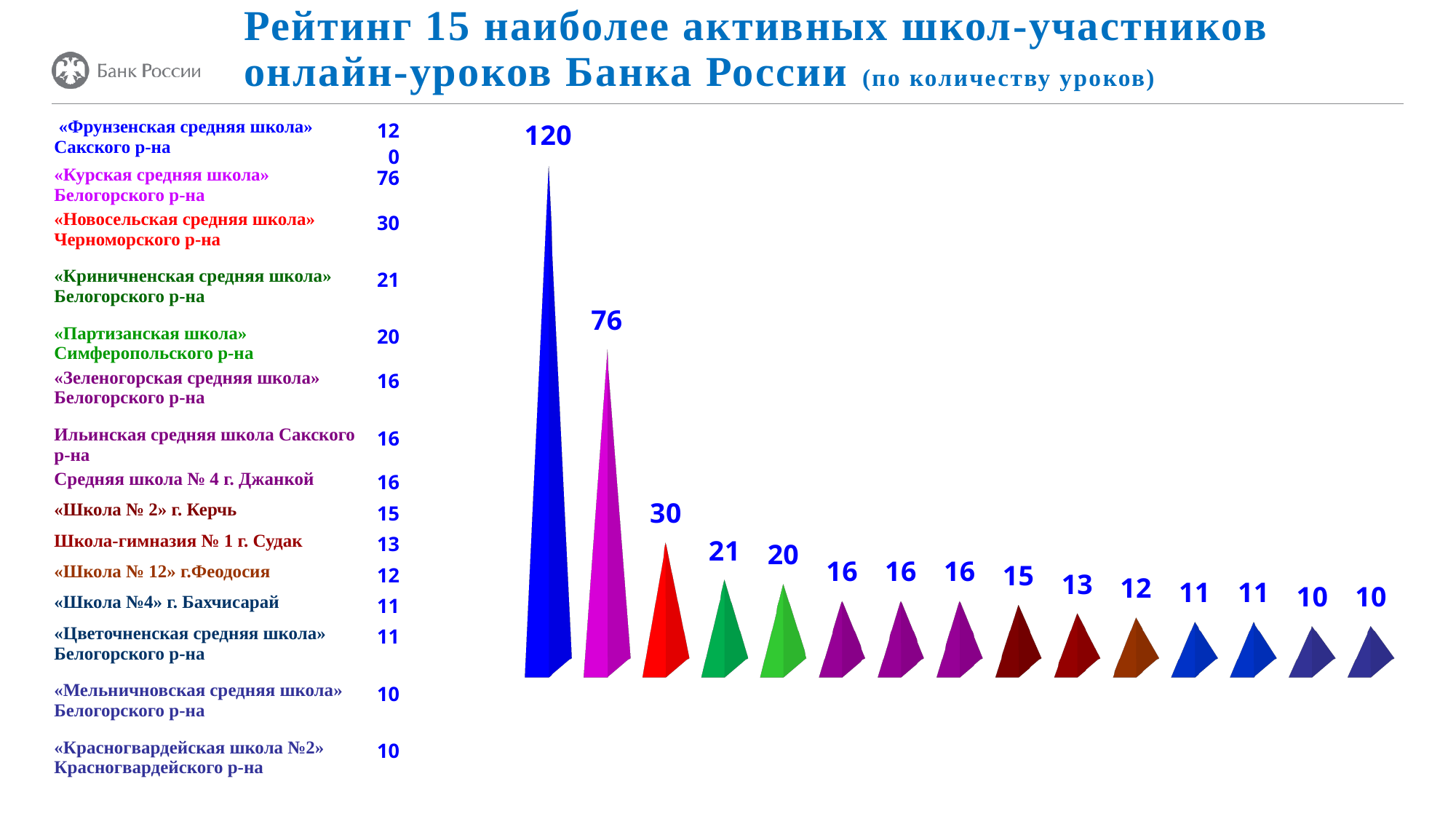
What kind of chart is shown on the slide? bar chart Which school has the highest number of lessons? «Фрунзенская средняя школа» Сакского р-на What is the lowest value shown in the chart? 10 How many schools (bars) are plotted in the chart? 15 How many lessons does «Курская средняя школа» Белогорского р-на have? 76 Which has more lessons: «Новосельская средняя школа» Черноморского р-на or «Криничненская средняя школа» Белогорского р-на? «Новосельская средняя школа» Черноморского р-на What is the value for «Школа № 2» г. Керчь? 15 How many bars in the chart have the value 16? 3 What is the difference between the two tallest bars (120 and 76)? 44 How many lessons does «Новосельская средняя школа» Черноморского р-на have? 30 Do the bar values rise or fall from left to right across the chart? fall What is the value of the tallest bar in the chart? 120